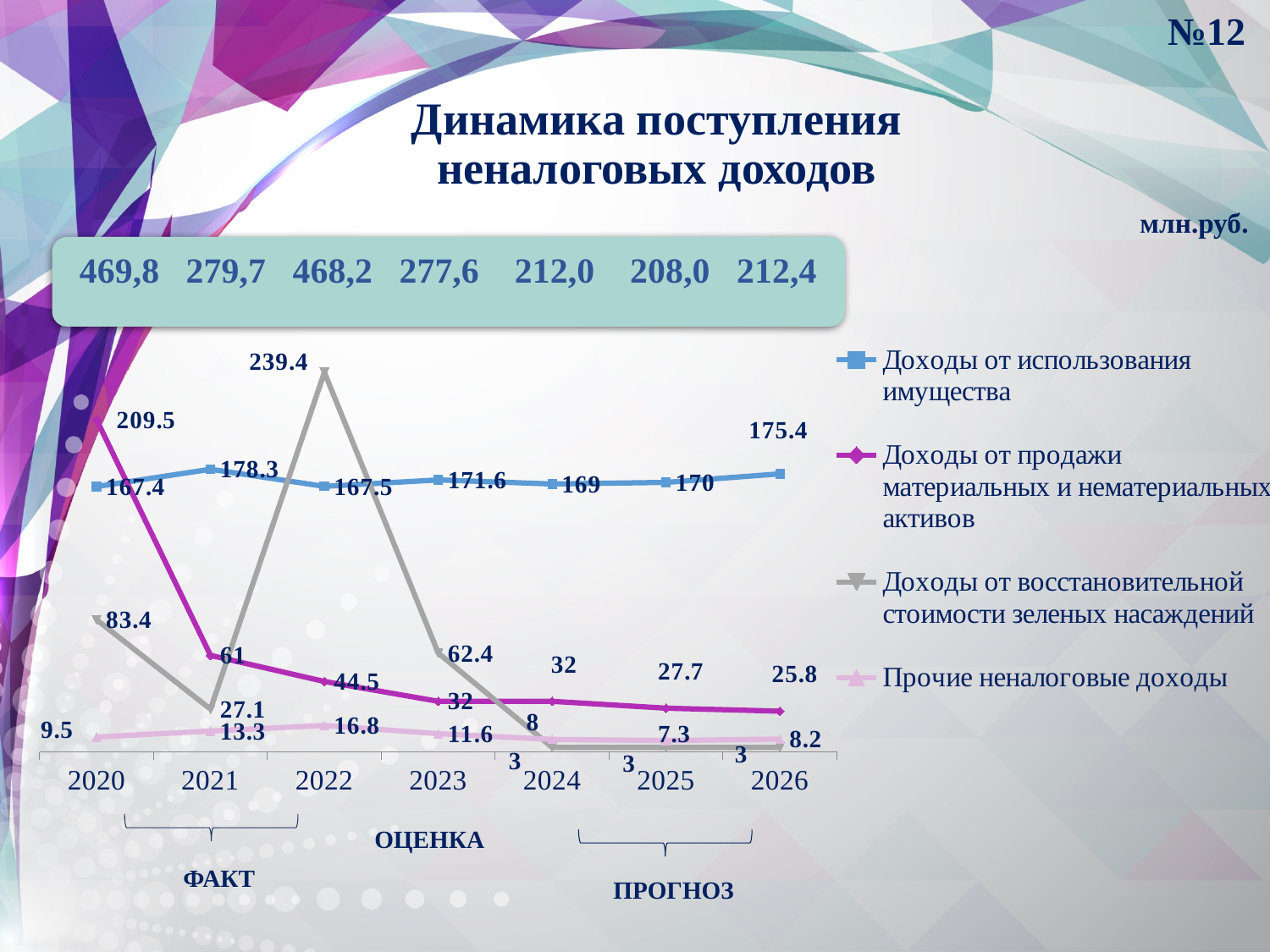
What is the value for Прочие неналоговые доходы in 2023? 11.6 How many years are plotted along the x axis? 7 How many series does the legend list? 4 Does Доходы от продажи материальных и нематериальных активов rise or fall from 2020 to 2026? fall In which year is Доходы от продажи материальных и нематериальных активов lowest? 2026 What is the value for Доходы от продажи материальных и нематериальных активов in 2020? 209.5 What kind of chart is shown on the slide? line chart In which year is Доходы от использования имущества highest? 2021 What is the value for Доходы от восстановительной стоимости зеленых насаждений in 2022? 239.4 What is the difference between Доходы от использования имущества in 2021 and in 2022? 10.8 Which is larger in 2023: Доходы от восстановительной стоимости зеленых насаждений or Доходы от продажи материальных и нематериальных активов? Доходы от восстановительной стоимости зеленых насаждений What is the value for Доходы от использования имущества in 2026? 175.4